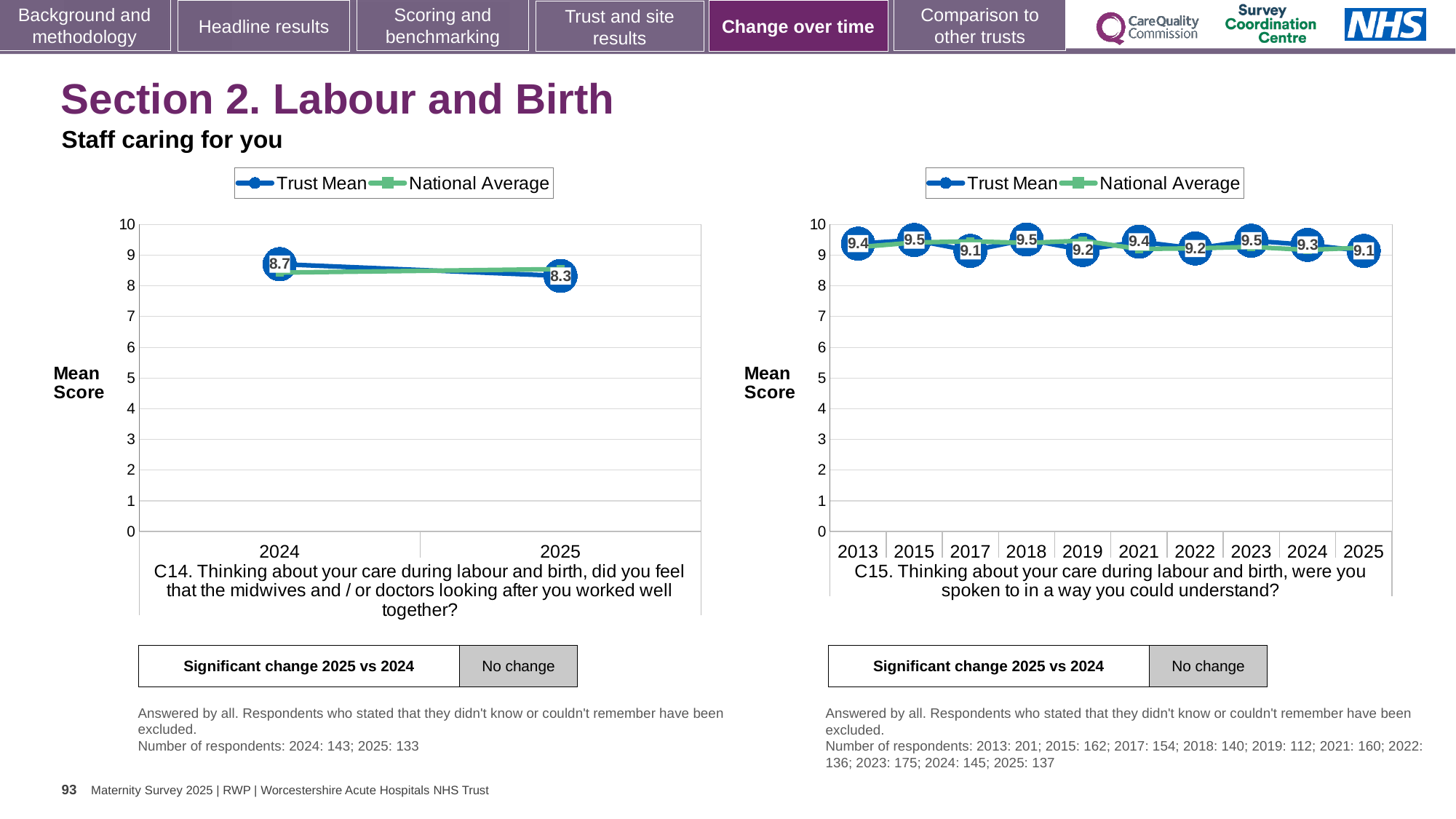
In the right chart (C15), how many years are plotted on the x axis? 10 In the left chart (C14), how many series does the legend list? 2 In the left chart (C14), what is the difference between the Trust Mean scores for 2024 and 2025? 0.4 In the right chart (C15), what is the Trust Mean score for 2017? 9.1 In the left chart (C14), what is the Trust Mean score for 2024? 8.7 In the right chart (C15), what is the Trust Mean score for 2025? 9.1 In the left chart (C14), does the Trust Mean rise or fall from 2024 to 2025? fall In the right chart (C15), what is the Trust Mean score for 2023? 9.5 In the left chart (C14), what is the Trust Mean score for 2025? 8.3 What type of chart is the right chart (C15)? line chart In the right chart (C15), what is the difference between the Trust Mean scores for 2013 and 2024? 0.1 In the right chart (C15), which is larger, the Trust Mean for 2018 or the Trust Mean for 2019? 2018